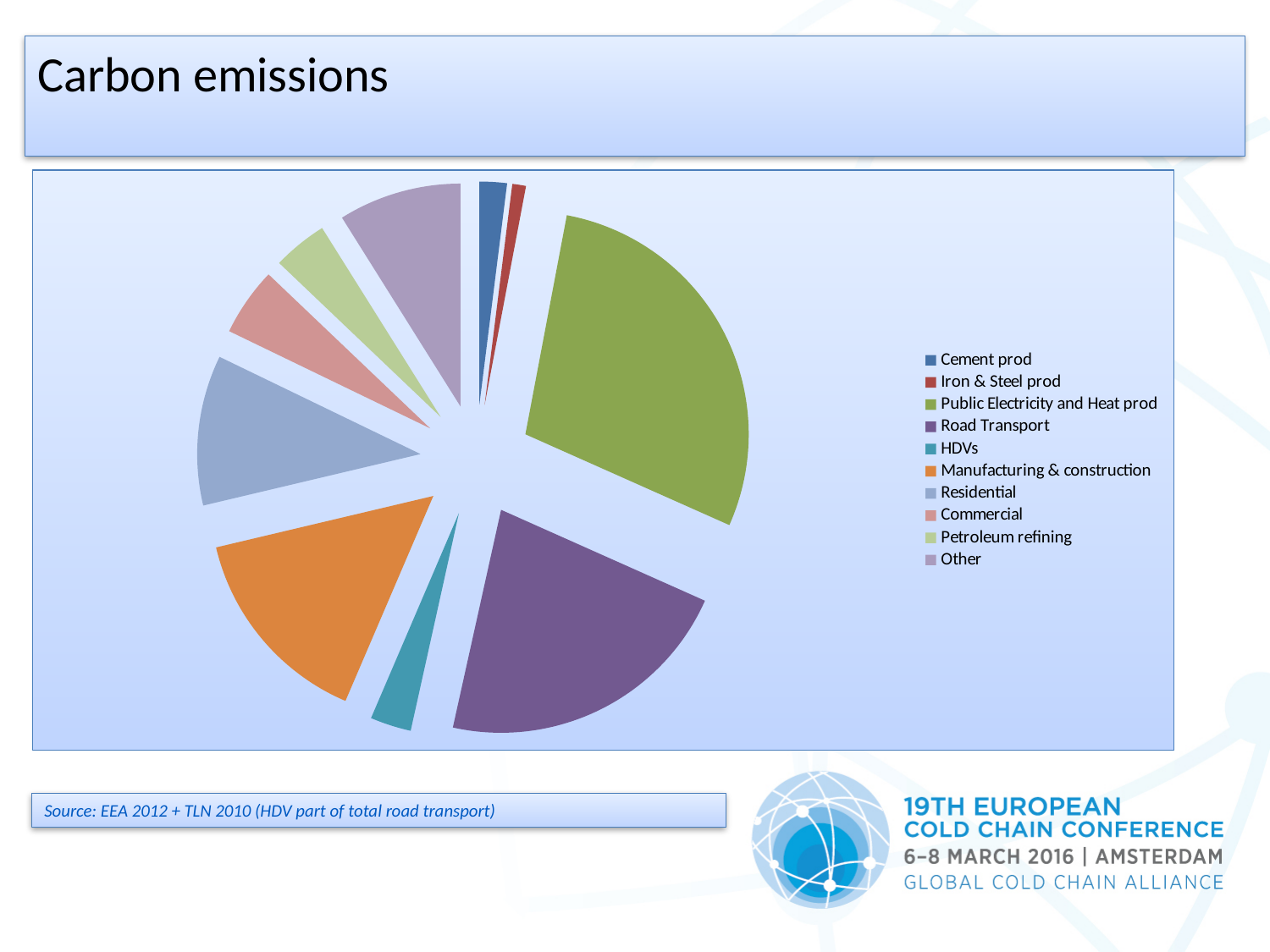
Which slice is larger, Public Electricity and Heat prod or Road Transport? Public Electricity and Heat prod What is the title of the slide containing the pie chart? Carbon emissions Which category is shown in green in the pie chart? Public Electricity and Heat prod Which slice is larger, HDVs or Road Transport? Road Transport What kind of chart is shown on the slide? pie chart Which category has the largest slice of the pie chart? Public Electricity and Heat prod Which slice is larger, Residential or Commercial? Residential How many categories does the pie chart's legend list? 10 Which category has the smallest slice of the pie chart? Iron & Steel prod